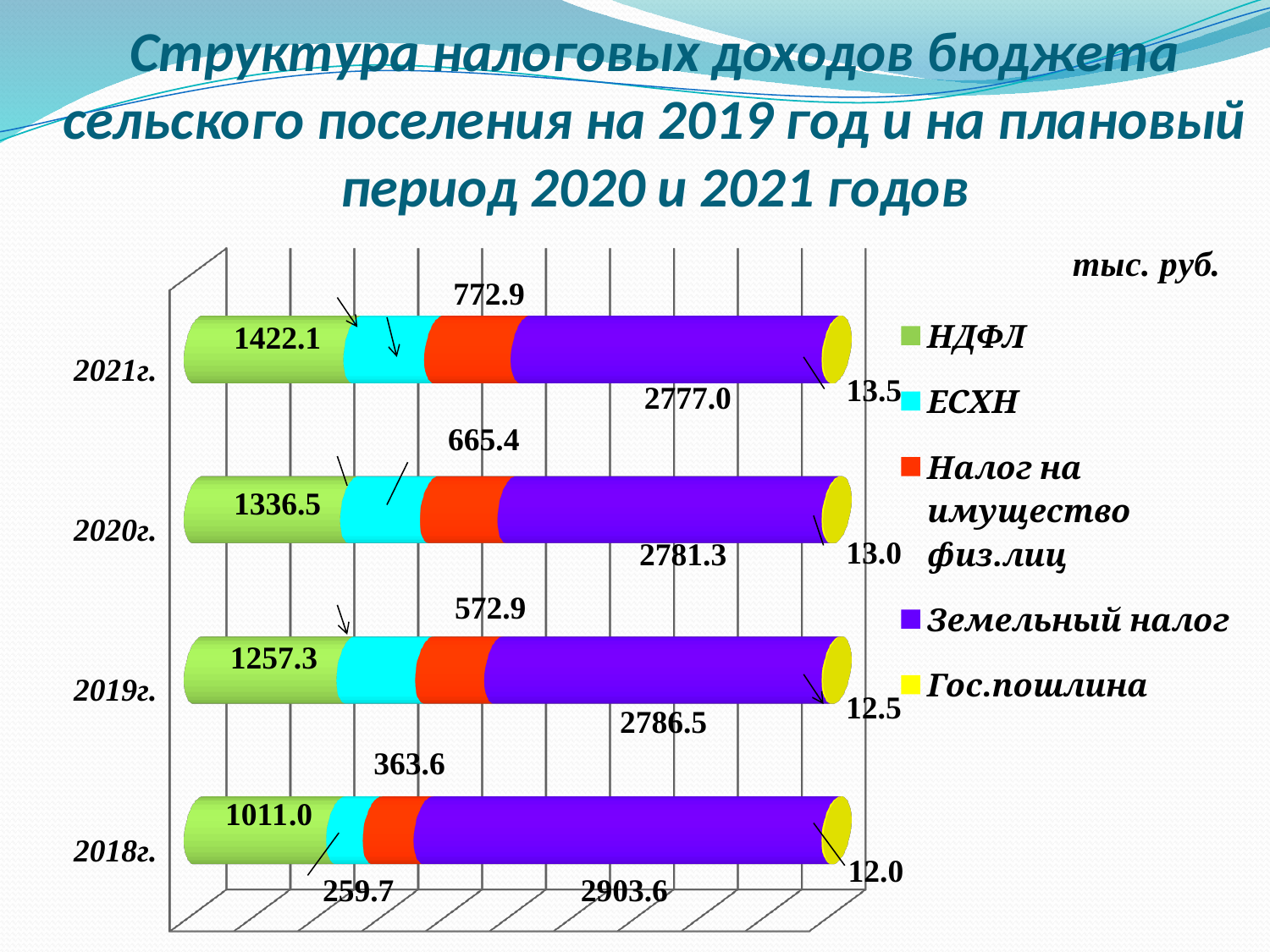
How many years (categories) are plotted on the chart? 4 What is the value of Гос.пошлина for 2019г.? 12.5 In which year is НДФЛ the highest? 2021г. What is the value of НДФЛ for 2021г.? 1422.1 What is the value of ЕСХН for 2018г.? 259.7 How many series does the legend list? 5 In what units are the values on the chart given? тыс. руб. In which year is Земельный налог the lowest? 2021г. What is the difference between НДФЛ in 2021г. and НДФЛ in 2018г.? 411.1 What kind of chart is shown on the slide? Stacked bar chart Does НДФЛ rise or fall from 2018г. to 2021г.? Rises What is the value of Земельный налог for 2018г.? 2903.6